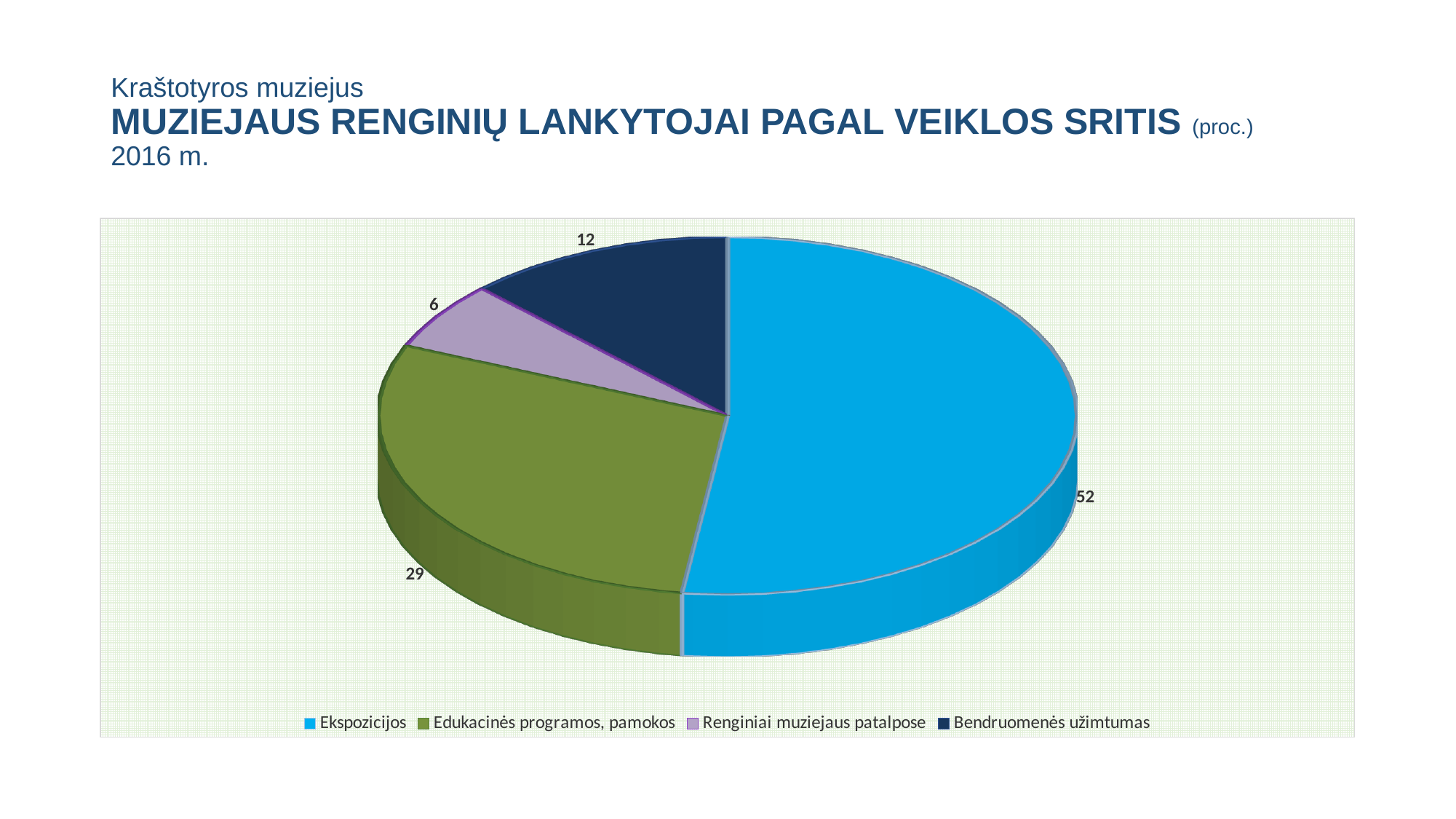
How many categories does the pie chart show? 4 Which category has the largest slice? Ekspozicijos Which category has the smallest slice? Renginiai muziejaus patalpose What is the difference between the values for Ekspozicijos and Edukacinės programos, pamokos? 23 What is the value for Edukacinės programos, pamokos? 29 What is the difference between the values for Bendruomenės užimtumas and Renginiai muziejaus patalpose? 6 What is the value for Bendruomenės užimtumas? 12 What is the value for Renginiai muziejaus patalpose? 6 What kind of chart is shown on the slide? pie chart Which year does the chart title refer to? 2016 m. What is the value for Ekspozicijos? 52 Which is larger, Bendruomenės užimtumas or Renginiai muziejaus patalpose? Bendruomenės užimtumas